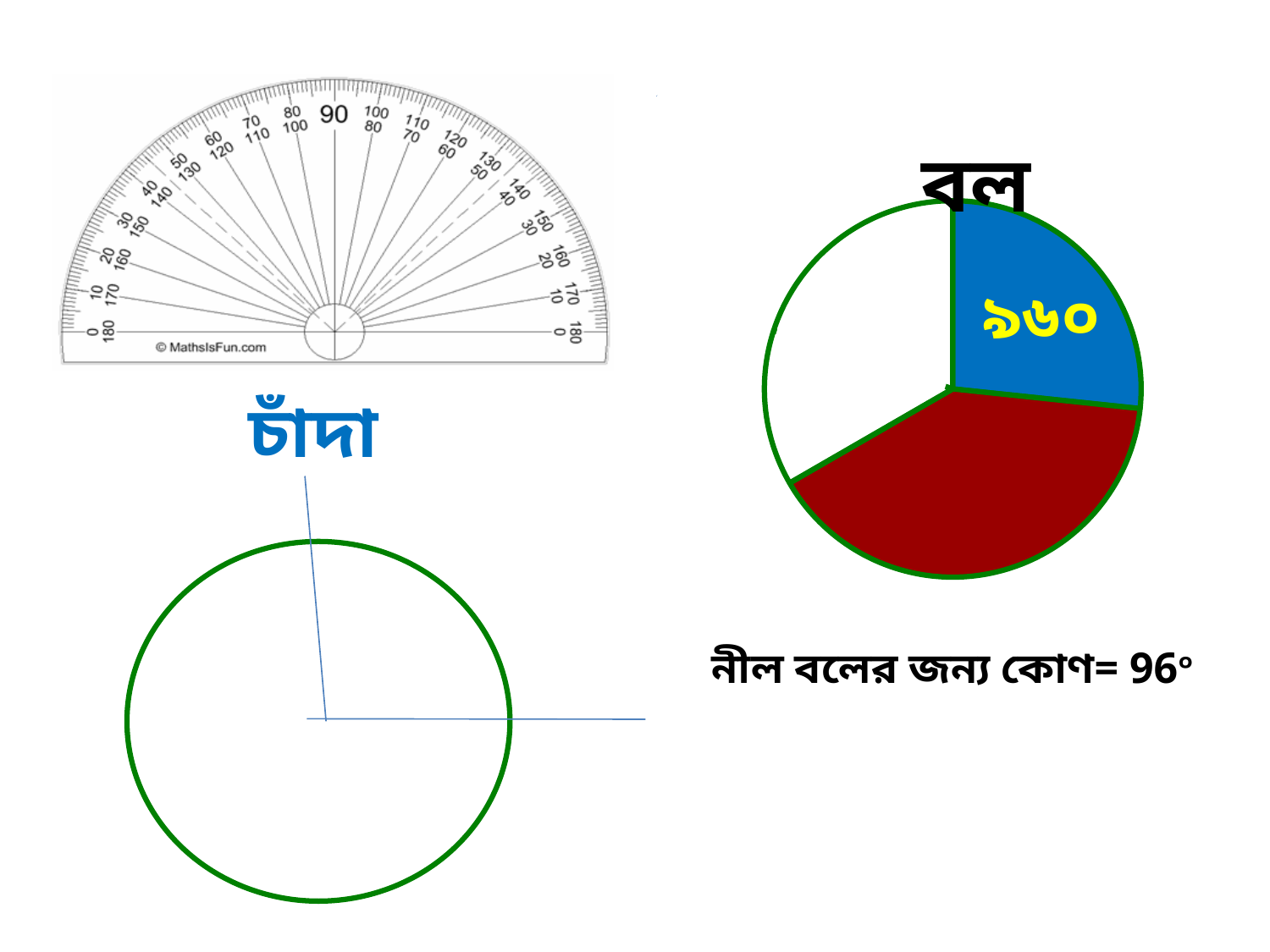
In the pie chart titled বল, which is larger, the red slice or the blue slice? the red slice In the pie chart titled বল, what colour is the slice that carries the label ১৬০? blue According to the text below the pie chart titled বল, what is the angle for the blue ball slice? 96° What is the title of the pie chart on the right side of the slide? বল In the pie chart titled বল, what value is printed on the blue slice? ১৬০ In the pie chart titled বল, which slice is the largest? the red slice What kind of chart is shown on the right side of the slide under the title বল? pie chart